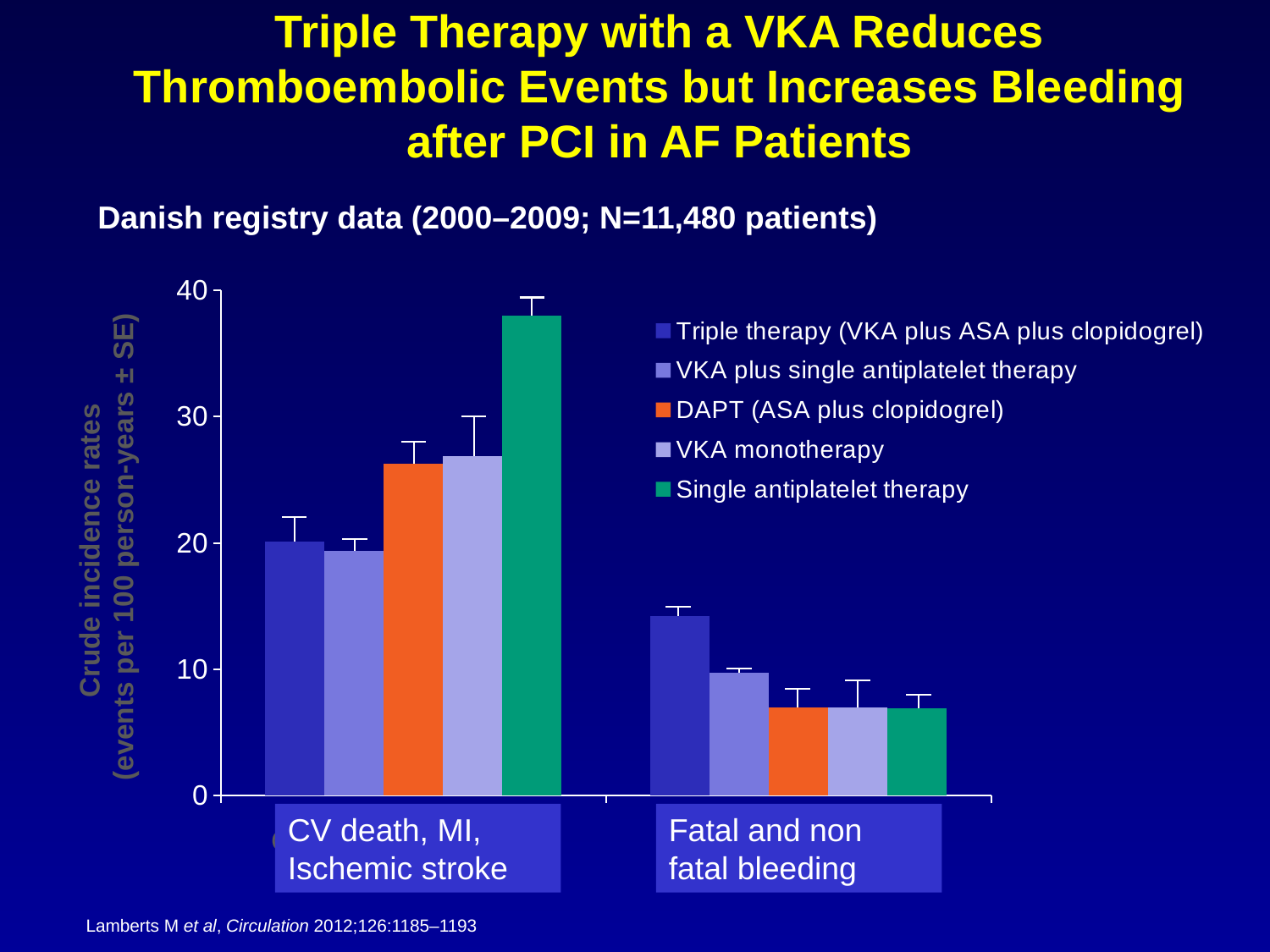
For fatal and non fatal bleeding, which is larger: Triple therapy or Single antiplatelet therapy? Triple therapy (VKA plus ASA plus clopidogrel) What kind of chart is shown on the slide? bar chart Which treatment has the highest crude incidence rate for CV death, MI, ischemic stroke? Single antiplatelet therapy How many series does the legend list? 5 What colour represents DAPT (ASA plus clopidogrel) in the chart? orange Is the value for DAPT (ASA plus clopidogrel) in the fatal and non fatal bleeding category greater or less than 10? less Is the value for Single antiplatelet therapy in the CV death, MI, ischemic stroke category greater or less than 30? greater For CV death, MI, ischemic stroke, which is larger: Triple therapy or DAPT (ASA plus clopidogrel)? DAPT (ASA plus clopidogrel) Is the value for DAPT (ASA plus clopidogrel) in the CV death, MI, ischemic stroke category greater or less than 20? greater Which treatment has the highest crude incidence rate for fatal and non fatal bleeding? Triple therapy (VKA plus ASA plus clopidogrel) How many outcome categories are shown on the x axis? 2